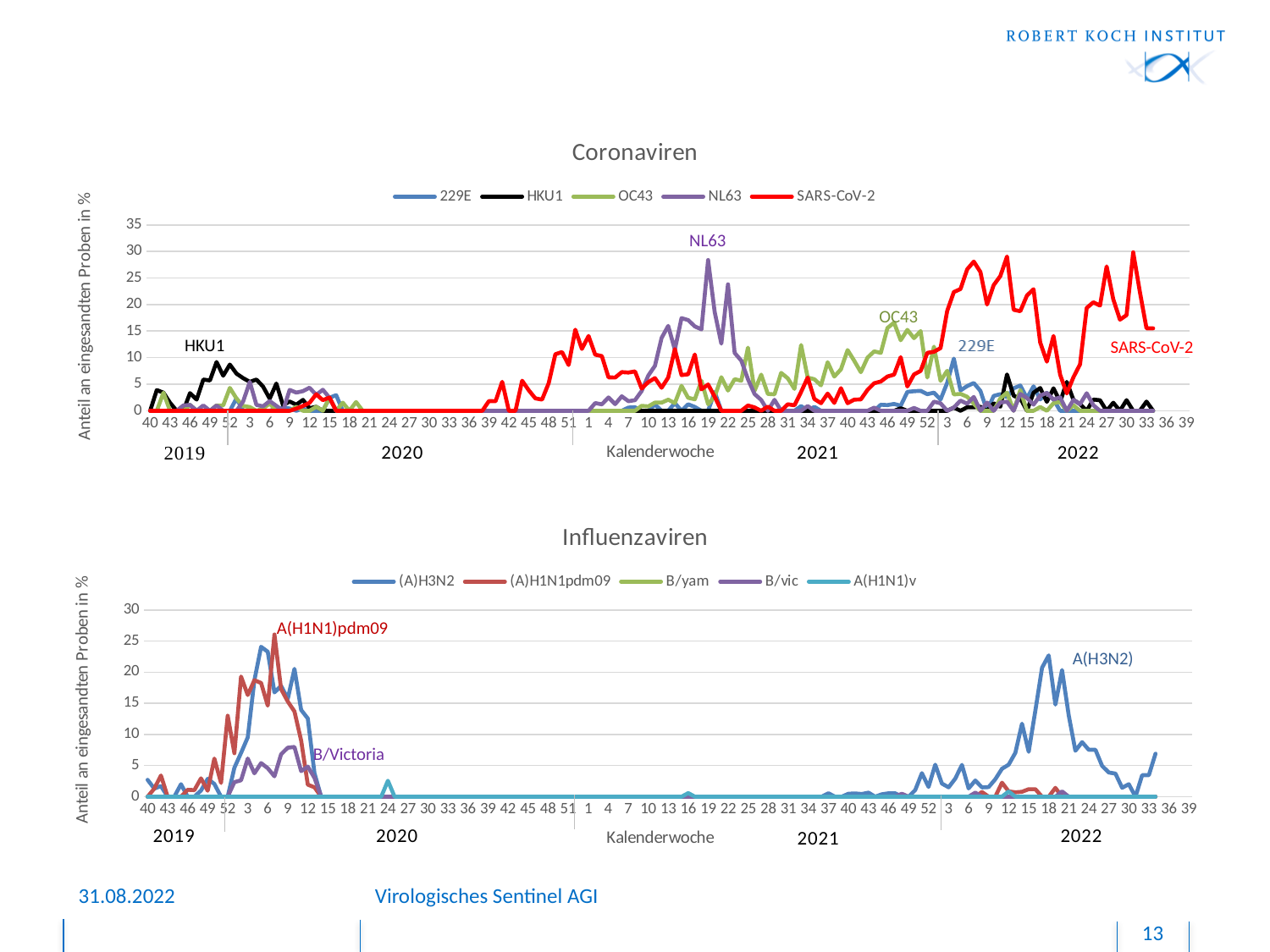
How many series does the legend of the Influenzaviren chart list? 5 In the Influenzaviren chart, which series reaches a higher peak, A(H1N1)pdm09 or B/Victoria? A(H1N1)pdm09 In the Coronaviren chart, which series reaches a higher peak, OC43 or HKU1? OC43 In the Coronaviren chart, is the peak value of HKU1 greater or less than 15? less In the Coronaviren chart, is the peak value of NL63 greater or less than 20? greater How many series does the legend of the Coronaviren chart list? 5 What is the y-axis label of the Influenzaviren chart? Anteil an eingesandten Proben in % In the Coronaviren chart, is the peak value of OC43 greater or less than 10? greater What is the x-axis label of the Coronaviren chart? Kalenderwoche What kind of chart is the Coronaviren chart? line chart